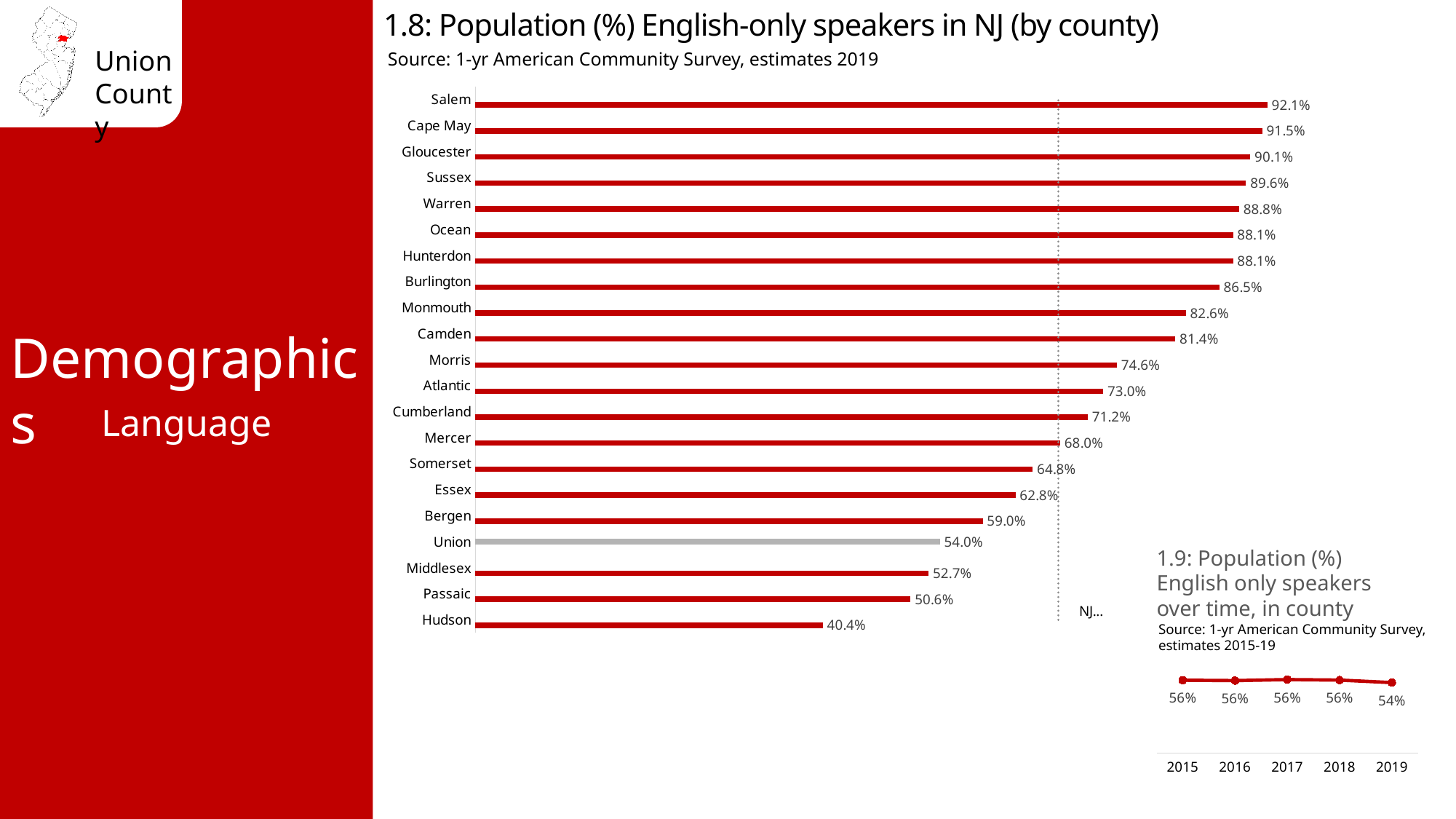
In chart 1.8, which county has the highest percentage of English-only speakers? Salem In chart 1.8, what is the value for Hudson? 40.4% In chart 1.9, how many years are plotted? 5 In chart 1.8, which is larger, the value for Bergen or the value for Middlesex? Bergen In chart 1.8, what is the difference between the values for Salem and Hudson? 51.7% In chart 1.8, how many counties are plotted? 21 In chart 1.8 (Population (%) English-only speakers in NJ by county), what is the value for Union? 54.0% In chart 1.8, what is the value for Mercer? 68.0% In chart 1.9, do the values rise or fall from 2018 to 2019? Fall In chart 1.8, which county has the lowest percentage of English-only speakers? Hudson What kind of chart is chart 1.8? Bar chart In chart 1.9 (Population (%) English only speakers over time, in county), what is the value for 2019? 54%